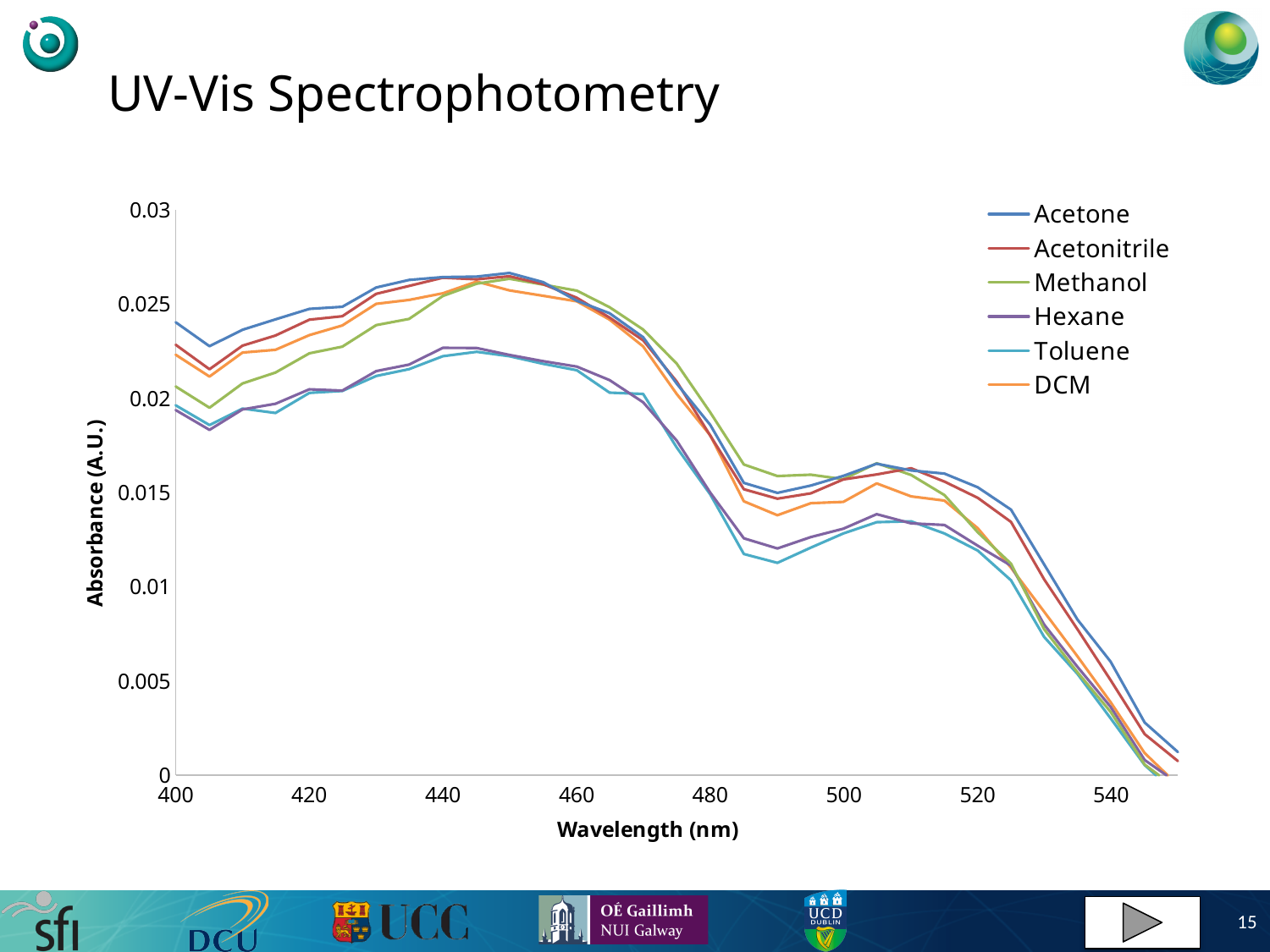
Is the absorbance for Methanol at 480 nm greater or less than 0.015? greater At 400 nm, which has the higher absorbance, Acetone or Toluene? Acetone What is the label of the x axis? Wavelength (nm) What is the label of the y axis? Absorbance (A.U.) Is the absorbance for Toluene at 520 nm greater or less than 0.015? less What kind of chart is shown on the slide? line chart Is the absorbance for Hexane at 440 nm greater or less than 0.025? less Do the absorbance values rise or fall between 500 nm and 550 nm? fall How many series does the legend list? 6 Which series has the highest absorbance at 400 nm? Acetone